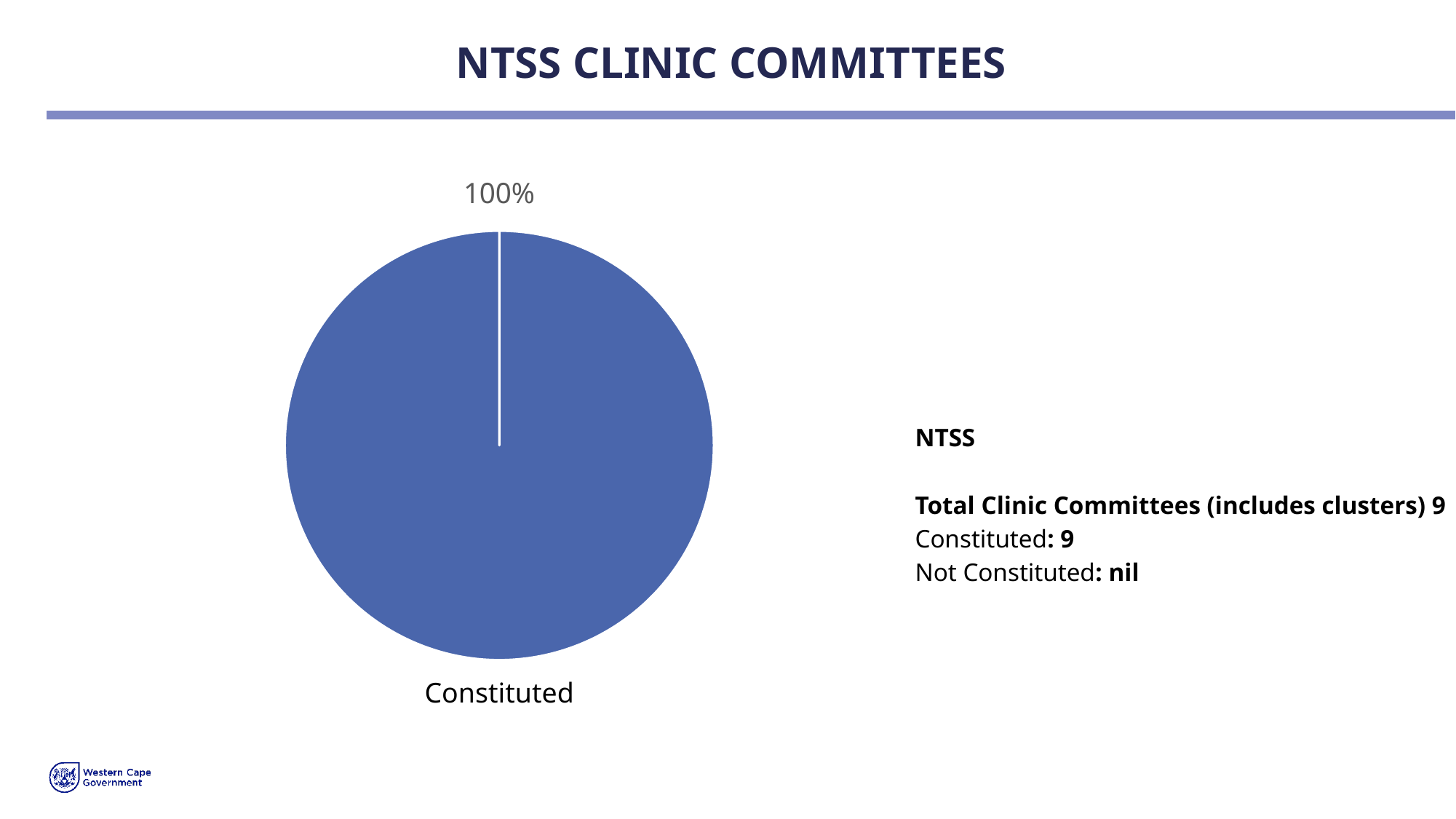
What is the title of the slide containing the pie chart? NTSS CLINIC COMMITTEES What share of the pie does the Constituted slice take up? 100% Is the value for Constituted greater or less than 50%? greater What percentage is shown for the Constituted slice of the pie chart? 100% What is the label of the only slice in the pie chart? Constituted How many slices does the pie chart have? 1 What kind of chart is shown on the slide? pie chart